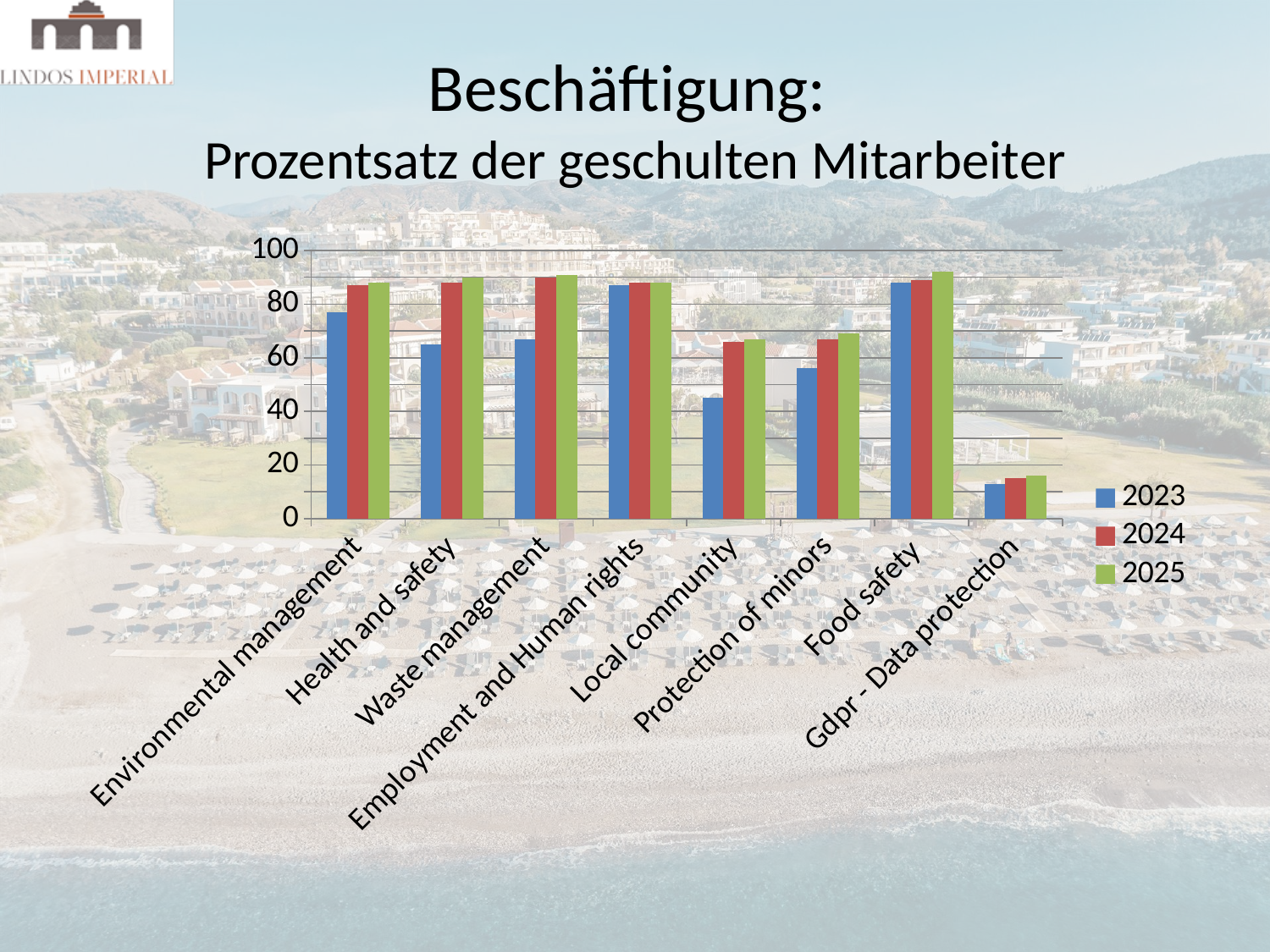
How many categories are shown on the x axis of the chart? 8 Which is larger for 2023: Local community or Food safety? Food safety Which years are listed in the legend? 2023, 2024, 2025 Which category has the lowest values across all three years? Gdpr - Data protection For Local community, do the values rise or fall from 2023 to 2025? rise What kind of chart is shown on the slide? bar chart Is the 2023 value for Local community greater or less than 60? less How many series does the legend list? 3 Is the 2023 value for Protection of minors greater or less than 40? greater Is the 2025 value for Gdpr - Data protection greater or less than 20? less For Health and safety, which is larger: the 2023 value or the 2025 value? 2025